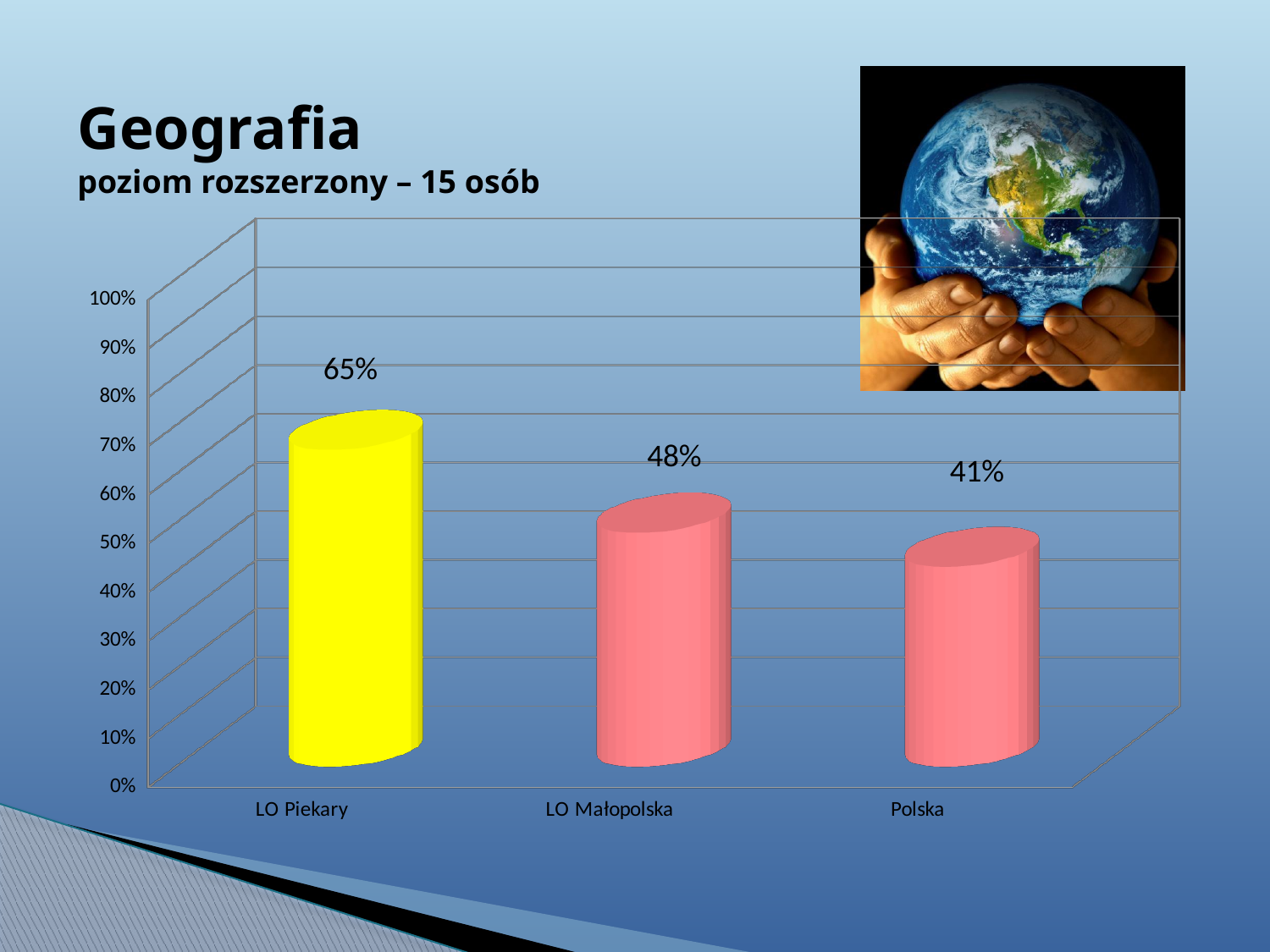
What is the value for Polska? 41% What is the value for LO Piekary? 65% What is the difference between the values for LO Piekary and Polska? 24% What is the difference between the values for LO Małopolska and Polska? 7% Is the value for Polska greater or less than 50%? less Do the values rise or fall from left to right across the categories? fall What kind of chart is shown on the slide? bar chart Which is larger, the value for LO Piekary or the value for LO Małopolska? LO Piekary Which category has the highest value? LO Piekary What is the value for LO Małopolska? 48% Which category has the lowest value? Polska How many categories are shown on the chart? 3